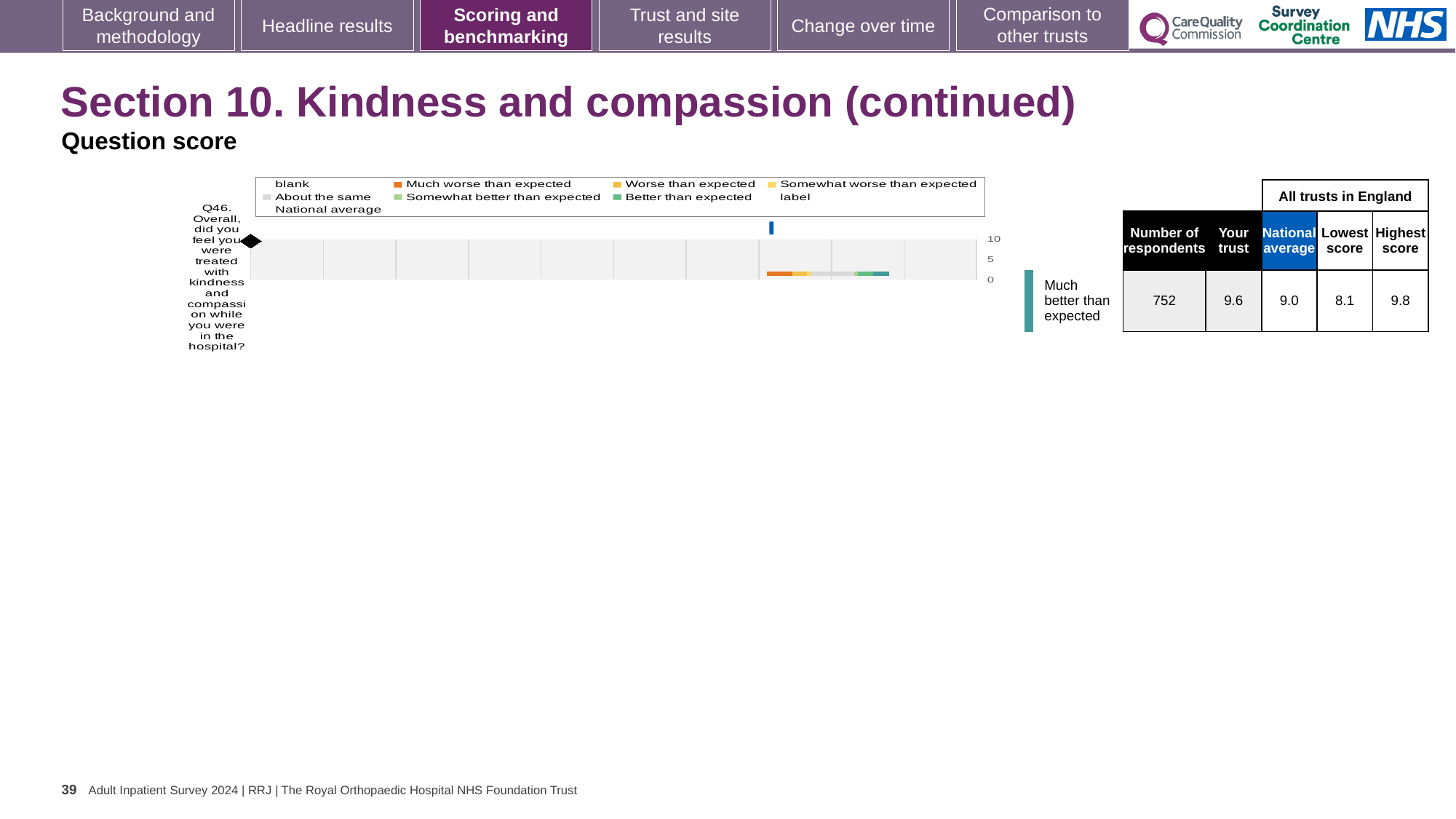
What is the lowest score among all trusts in England for Q46? 8.1 How many entries does the chart legend list? 9 Which question number is plotted on the chart? Q46 What is the national average score for Q46 shown next to the chart? 9.0 How many respondents answered Q46? 752 What kind of chart is shown on the slide? bar chart What is the 'Your trust' score for Q46 shown next to the chart? 9.6 What is the difference between the 'Your trust' score and the national average for Q46? 0.6 What is the highest value shown on the chart's axis? 10 Is the 'Your trust' score for Q46 larger or smaller than the national average? larger How many questions (categories) are plotted on the chart? 1 What is the highest score among all trusts in England for Q46? 9.8